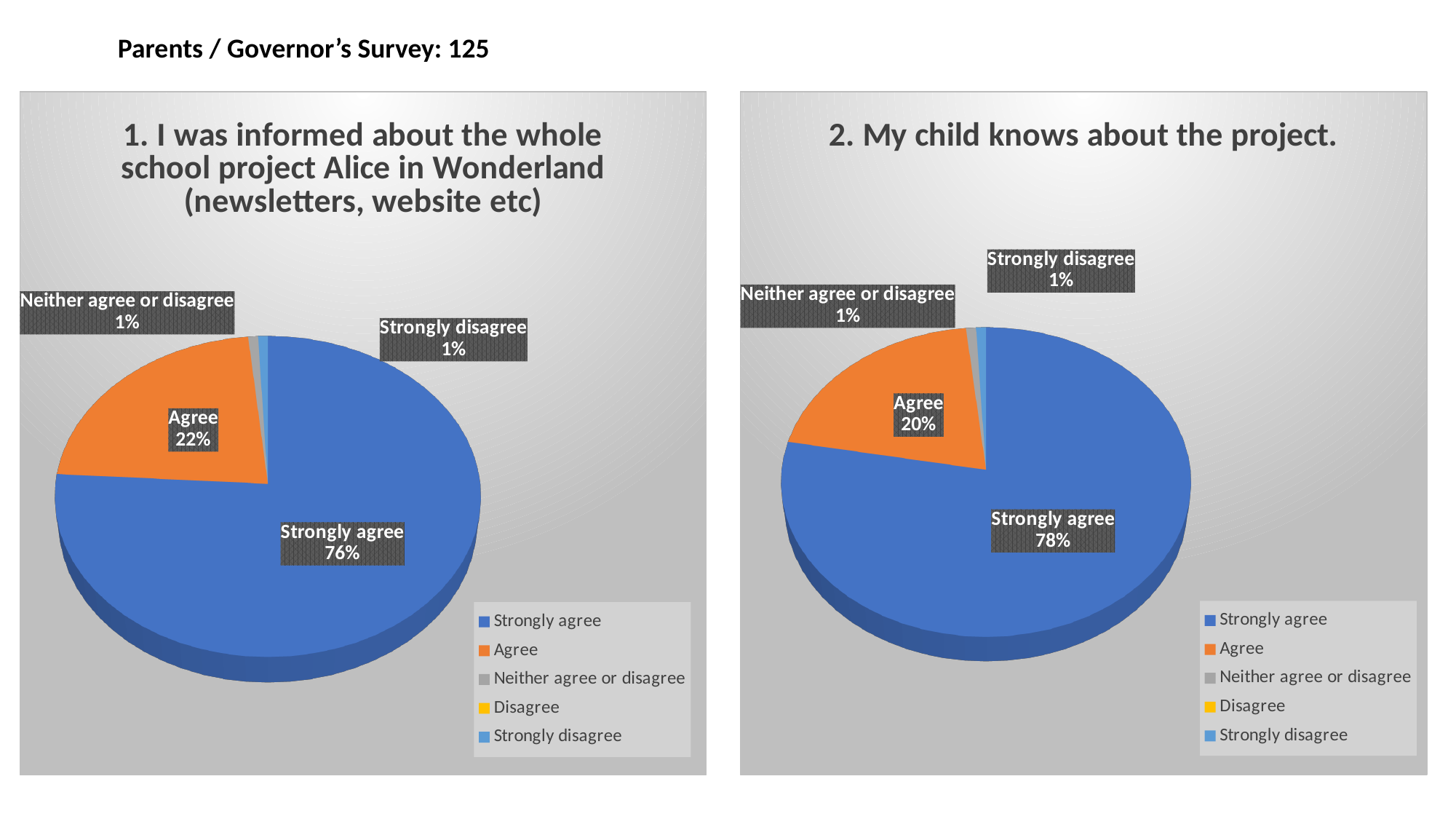
In the left chart ("1. I was informed about the whole school project Alice in Wonderland"), which response has the largest share? Strongly agree In the right chart ("2. My child knows about the project."), what is the difference in percentage points between Strongly agree and Agree? 58 What type of chart is used on this slide? Pie chart Which chart has the larger Strongly agree share, the left chart (question 1) or the right chart (question 2)? The right chart (question 2) In the right chart ("2. My child knows about the project."), what percentage of respondents chose Strongly disagree? 1% In the left chart ("1. I was informed about the whole school project Alice in Wonderland"), what percentage of respondents chose Strongly agree? 76% In the right chart ("2. My child knows about the project."), which response has the largest share? Strongly agree In the right chart ("2. My child knows about the project."), what percentage of respondents chose Agree? 20% How many entries does the legend of the left chart ("1. I was informed about the whole school project Alice in Wonderland") list? 5 In the left chart ("1. I was informed about the whole school project Alice in Wonderland"), what is the difference in percentage points between Strongly agree and Agree? 54 In the left chart ("1. I was informed about the whole school project Alice in Wonderland"), what percentage of respondents chose Agree? 22% In the right chart ("2. My child knows about the project."), what percentage of respondents chose Strongly agree? 78%